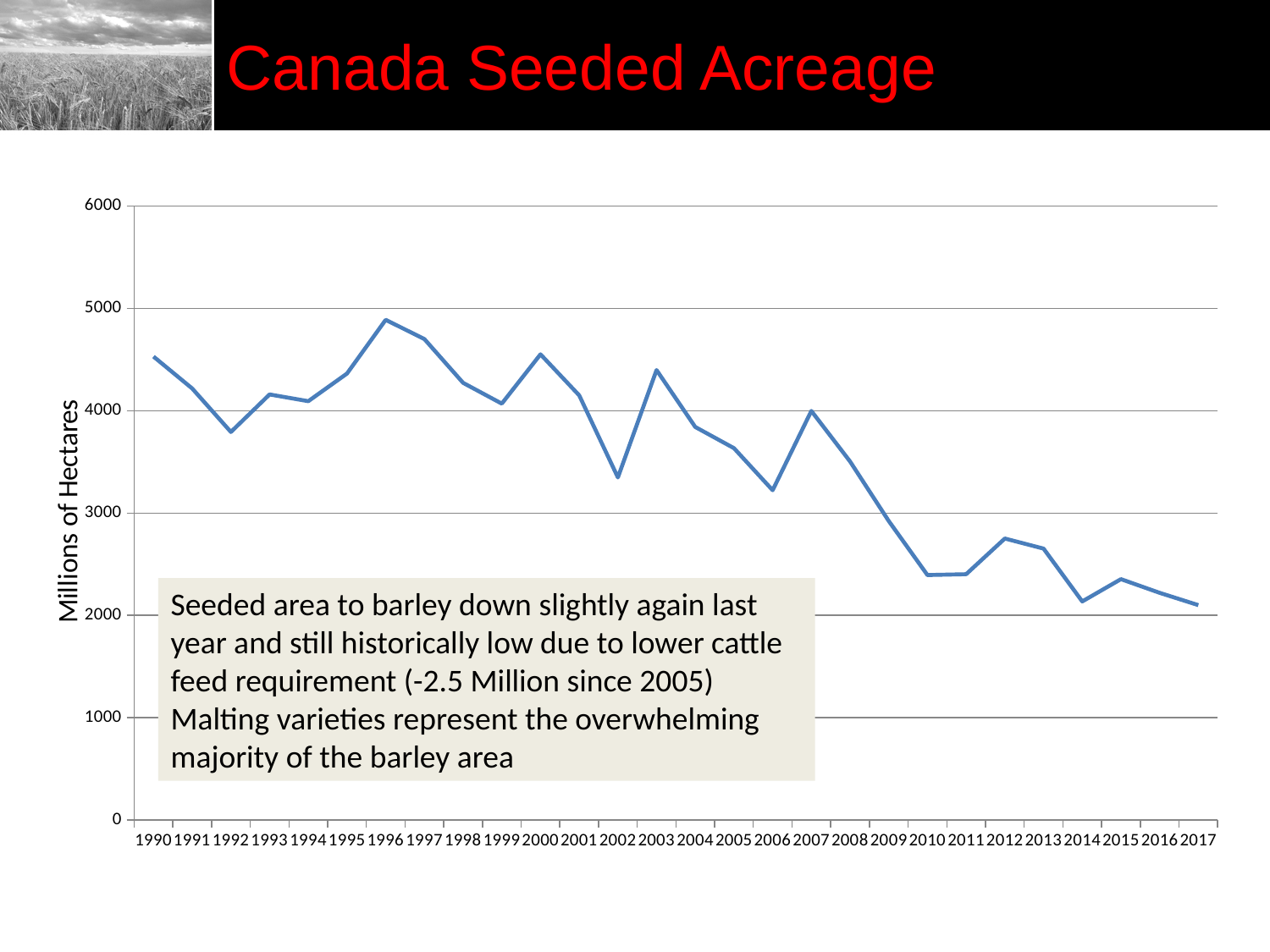
What is the label on the vertical axis of the chart? Millions of Hectares Is the value for 2010 greater or less than 3000? less Which year has the highest seeded acreage on the chart? 1996 What is the title of the slide containing the chart? Canada Seeded Acreage What kind of chart is shown on the slide? line chart Overall, do the values rise or fall from 1990 to 2017? fall Is the value for 1996 greater or less than 4000? greater How many years are plotted along the x axis of the chart? 28 Is the value for 2012 greater or less than 3000? less Which is larger, the value for 2002 or the value for 2003? 2003 Which is larger, the value for 1996 or the value for 2006? 1996